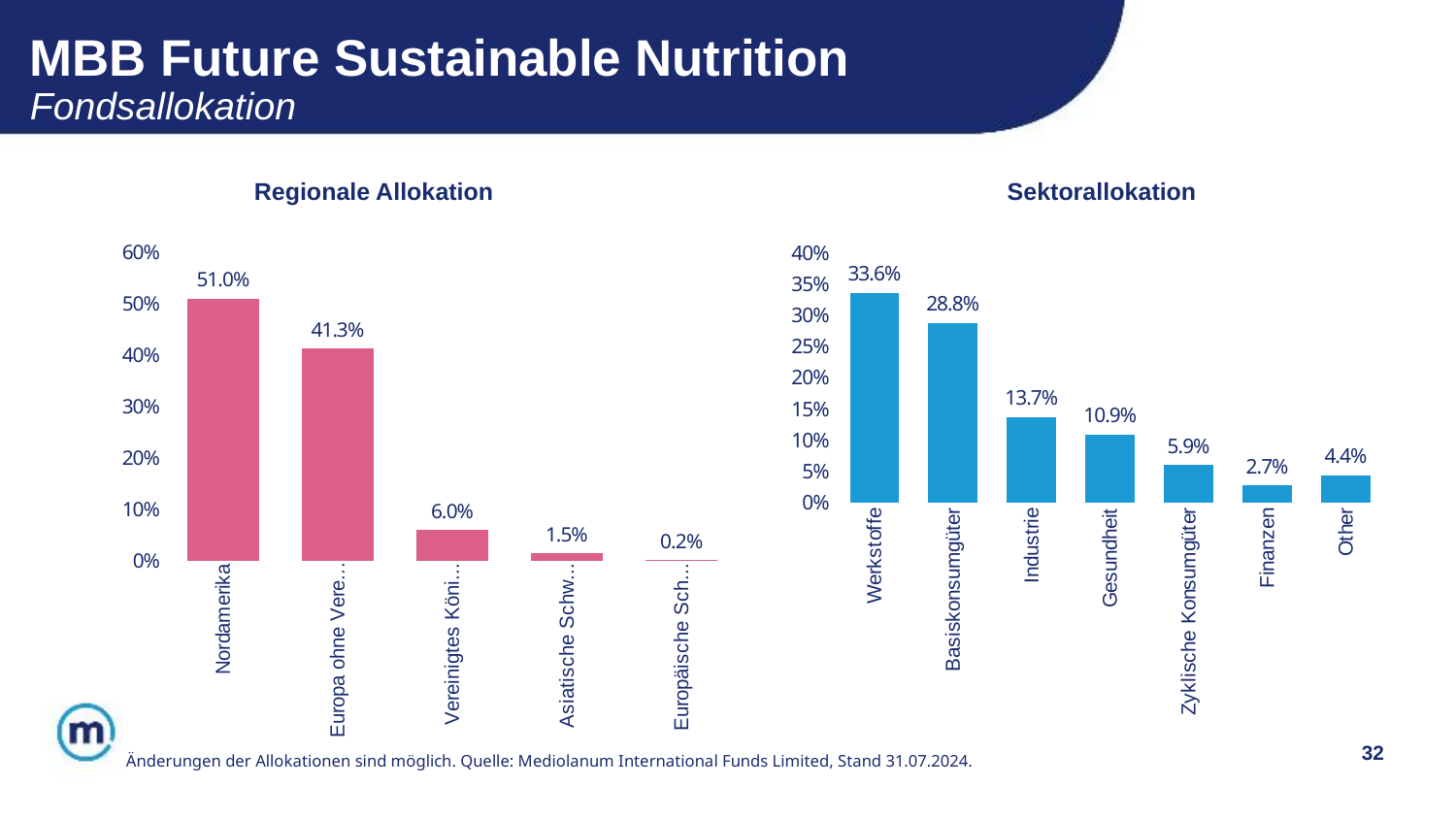
What type of chart is the Sektorallokation chart? Bar chart In the Regionale Allokation chart, how many bars are plotted? 5 In the Sektorallokation chart, which sector has the highest value? Werkstoffe In the Sektorallokation chart, what is the value for Basiskonsumgüter? 28.8% In the Regionale Allokation chart, what is the value for Nordamerika? 51.0% In the Sektorallokation chart, how many sectors are shown? 7 In the Sektorallokation chart, which sector has the lowest value? Finanzen In the Regionale Allokation chart, which category has the highest value? Nordamerika In the Sektorallokation chart, which is larger: Zyklische Konsumgüter or Other? Zyklische Konsumgüter In the Sektorallokation chart, what is the difference between Werkstoffe and Industrie? 19.9% In the Sektorallokation chart, what is the value for Gesundheit? 10.9% In the Regionale Allokation chart, what is the difference between the highest value (51.0%) and the second-highest value (41.3%)? 9.7%